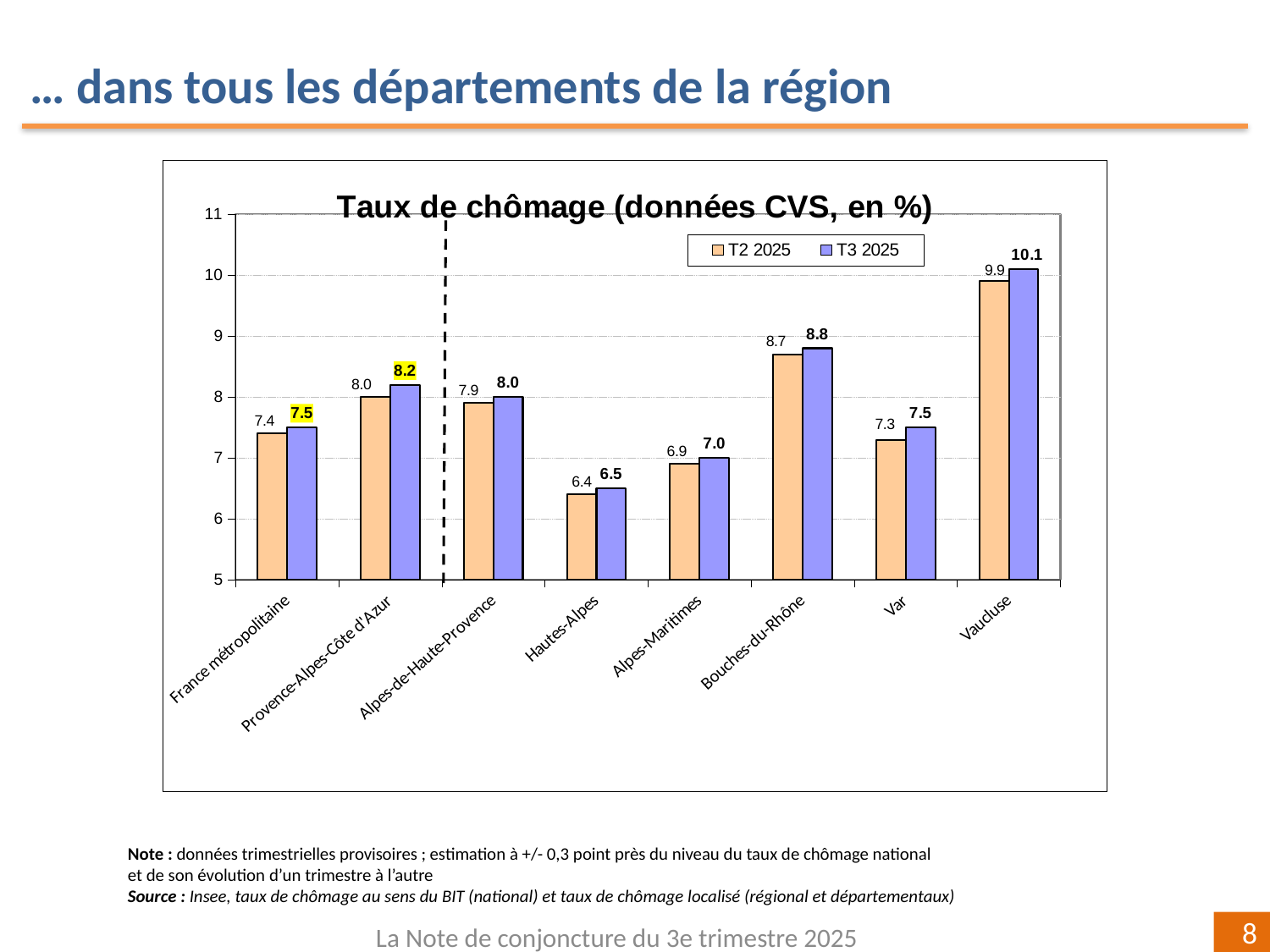
Which category has the highest T3 2025 value? Vaucluse What is the T3 2025 unemployment rate for Vaucluse? 10.1 How many series does the legend list? 2 What kind of chart is this? bar chart What is the T3 2025 value for Provence-Alpes-Côte d'Azur? 8.2 Which is larger: the T3 2025 value for Var or the T3 2025 value for Alpes-Maritimes? Var What is the T2 2025 value for Bouches-du-Rhône? 8.7 What is the title of the chart? Taux de chômage (données CVS, en %) What is the difference between the T3 2025 values for Vaucluse and Hautes-Alpes? 3.6 Which category has the lowest T2 2025 value? Hautes-Alpes How many categories are shown on the x axis? 8 What is the difference between the T3 2025 and T2 2025 values for Provence-Alpes-Côte d'Azur? 0.2